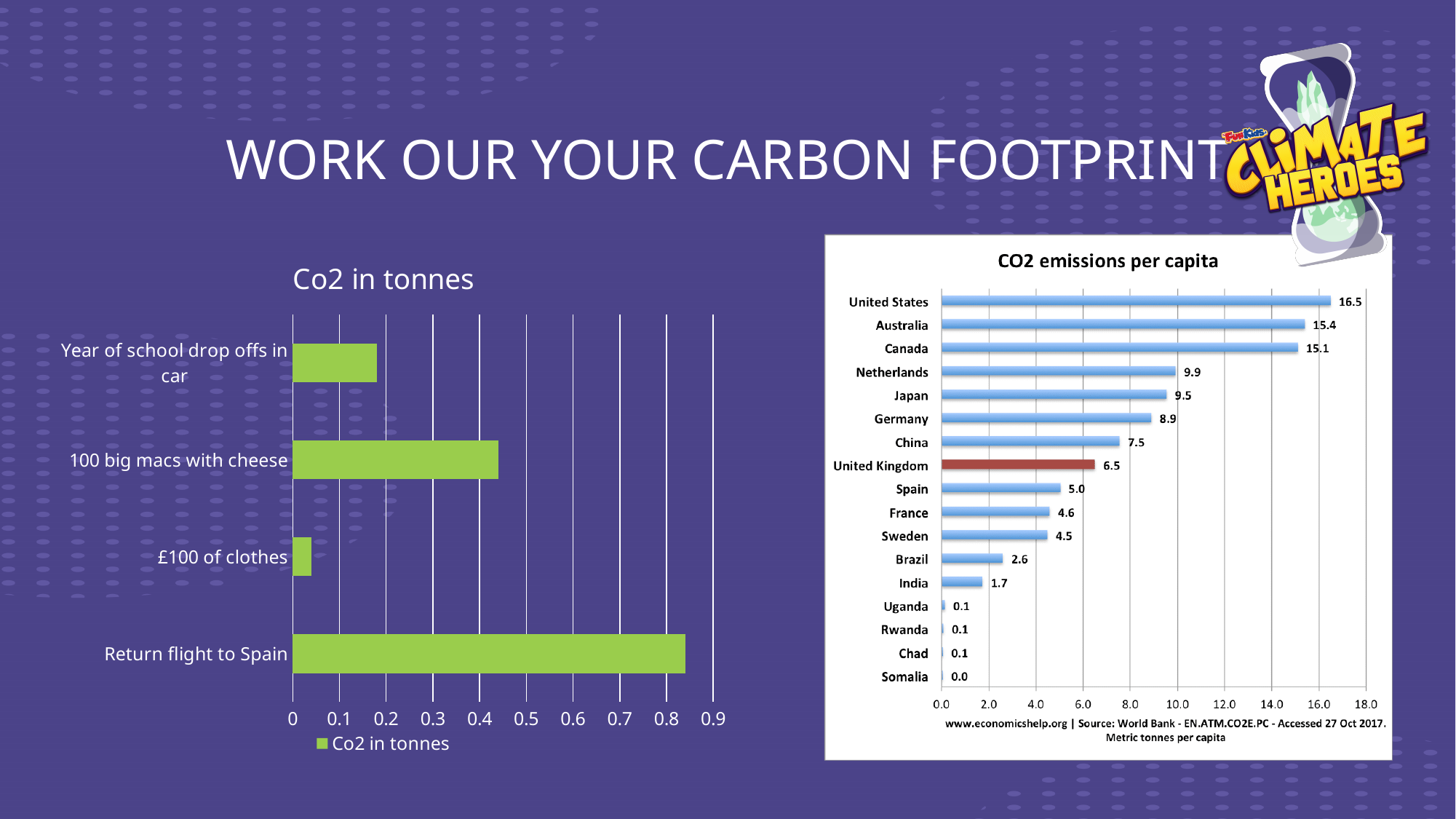
In the 'Co2 in tonnes' chart on the left, is the value for 'Return flight to Spain' greater or less than 0.8? greater In the 'CO2 emissions per capita' chart, what is the value for Germany? 8.9 In the 'CO2 emissions per capita' chart, which country has the highest value? United States In the 'CO2 emissions per capita' chart, what is the difference between the values for Australia and Canada? 0.3 In the 'Co2 in tonnes' chart on the left, is the value for '100 big macs with cheese' greater or less than 0.4? greater What kind of chart is the 'Co2 in tonnes' chart on the left? Bar chart In the 'CO2 emissions per capita' chart, which country has the lowest value? Somalia In the 'Co2 in tonnes' chart on the left, which category has the highest value? Return flight to Spain How many countries are shown in the 'CO2 emissions per capita' chart? 17 In the 'CO2 emissions per capita' chart, what is the difference between the values for the United States and the United Kingdom? 10.0 In the 'CO2 emissions per capita' chart, which has a larger value, China or Spain? China In the 'CO2 emissions per capita' chart, what is the value for the United Kingdom? 6.5